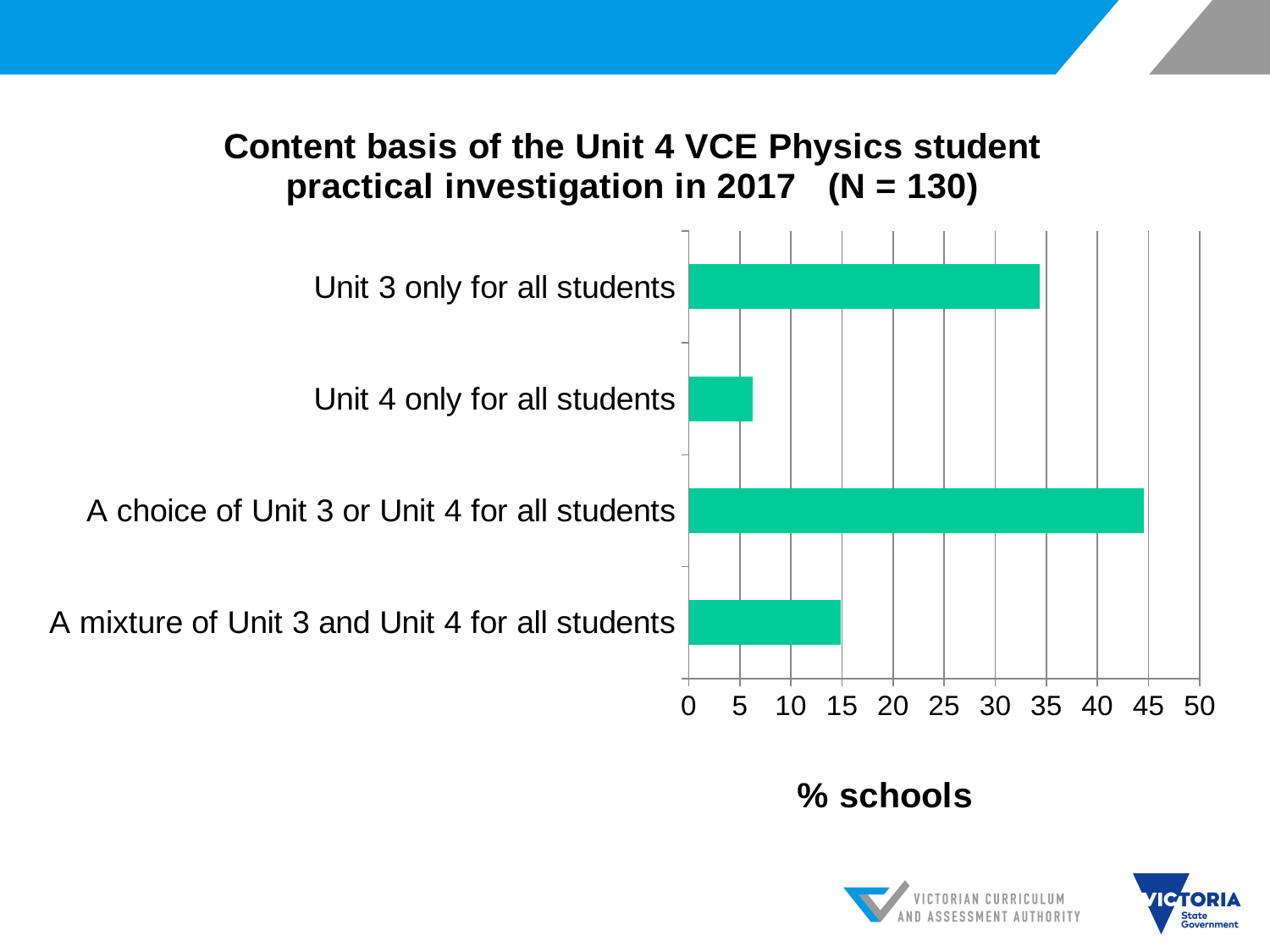
Is the value for 'Unit 3 only for all students' greater or less than 30? greater What kind of chart is shown on the slide? bar chart Is the value for 'Unit 4 only for all students' greater or less than 10? less Which category has the highest percentage of schools? A choice of Unit 3 or Unit 4 for all students Which category has the lowest percentage of schools? Unit 4 only for all students Is the value for 'A mixture of Unit 3 and Unit 4 for all students' greater or less than 20? less Which is larger: the value for 'Unit 4 only for all students' or 'A mixture of Unit 3 and Unit 4 for all students'? A mixture of Unit 3 and Unit 4 for all students How many categories are plotted in the chart? 4 What sample size (N) is given in the chart title? N = 130 Which is larger: the value for 'Unit 3 only for all students' or 'A mixture of Unit 3 and Unit 4 for all students'? Unit 3 only for all students What is the label of the horizontal axis? % schools